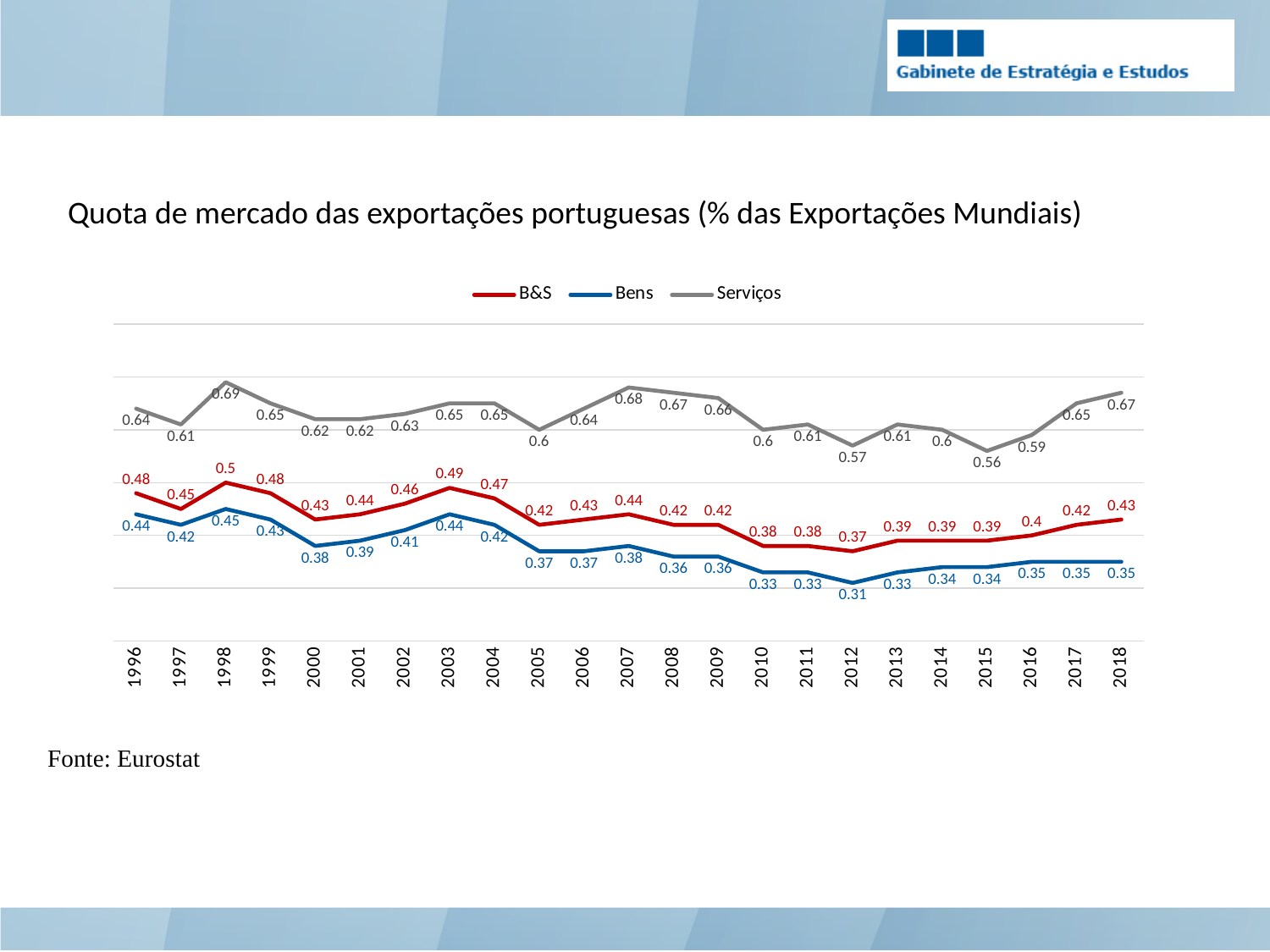
In which year does Serviços reach its lowest value? 2015 Which series has the higher value in 2007, B&S or Bens? B&S What is the difference between the Serviços and Bens values in 2018? 0.32 How many years are shown on the x axis? 23 Does the Bens series rise or fall from 1996 to 2012? fall What is the value of Serviços in 1998? 0.69 What is the value of B&S in 2018? 0.43 How many series does the legend list? 3 What is the title of the chart? Quota de mercado das exportações portuguesas (% das Exportações Mundiais) What type of chart is shown on the slide? line chart What is the value of Bens in 2012? 0.31 In which year does B&S reach its highest value? 1998